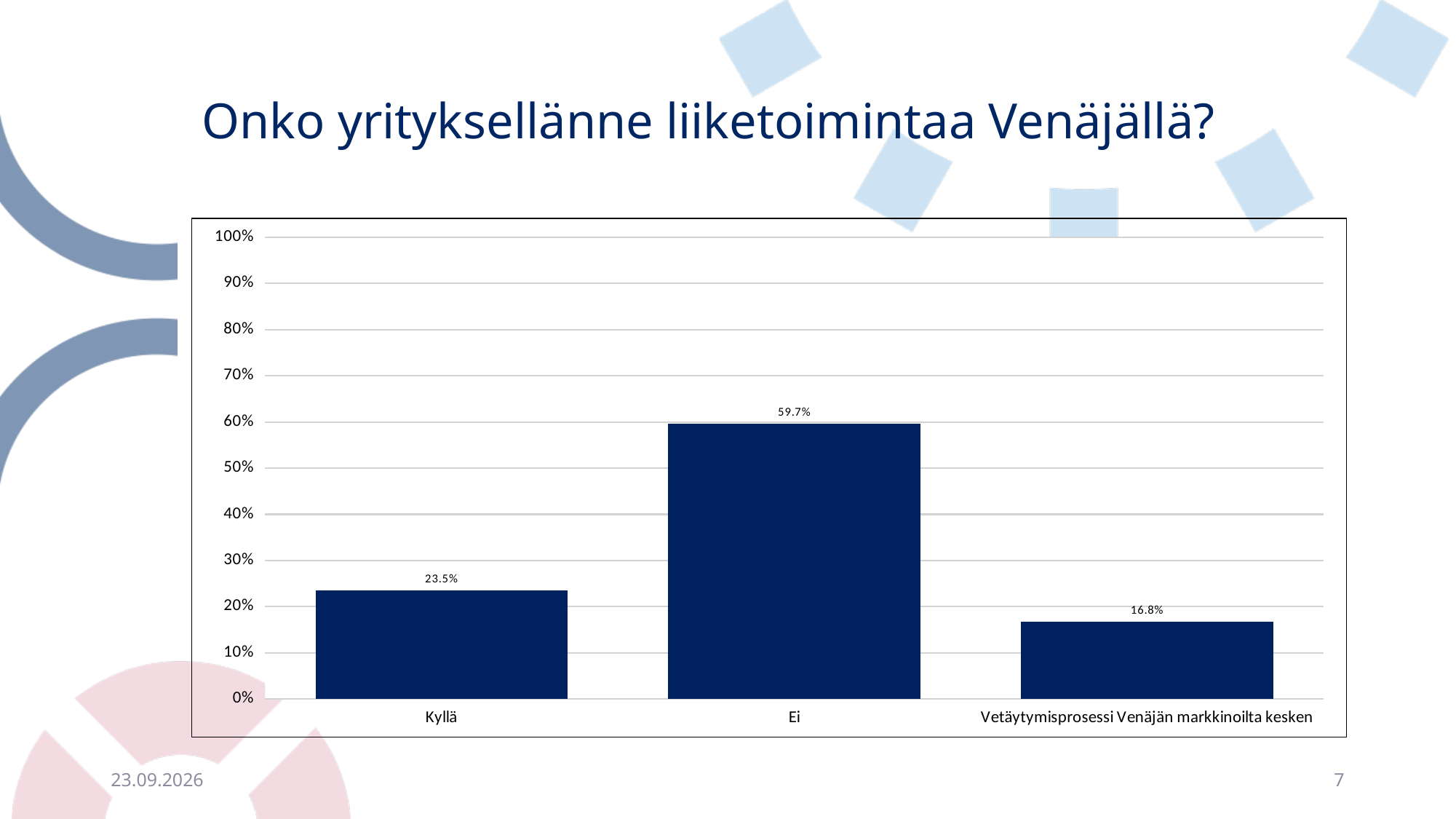
Is the value for Ei greater or less than 50%? greater What is the value for Vetäytymisprosessi Venäjän markkinoilta kesken? 16.8% What is the value for Ei? 59.7% What is the difference between the values for Kyllä and Vetäytymisprosessi Venäjän markkinoilta kesken? 6.7% What is the value for Kyllä? 23.5% What is the title of the slide containing the chart? Onko yrityksellänne liiketoimintaa Venäjällä? Which category has the lowest value? Vetäytymisprosessi Venäjän markkinoilta kesken Which category has the highest value? Ei What kind of chart is shown on the slide? bar chart What is the difference between the values for Ei and Kyllä? 36.2% Which is larger, the value for Kyllä or the value for Vetäytymisprosessi Venäjän markkinoilta kesken? Kyllä How many categories are shown on the x axis? 3